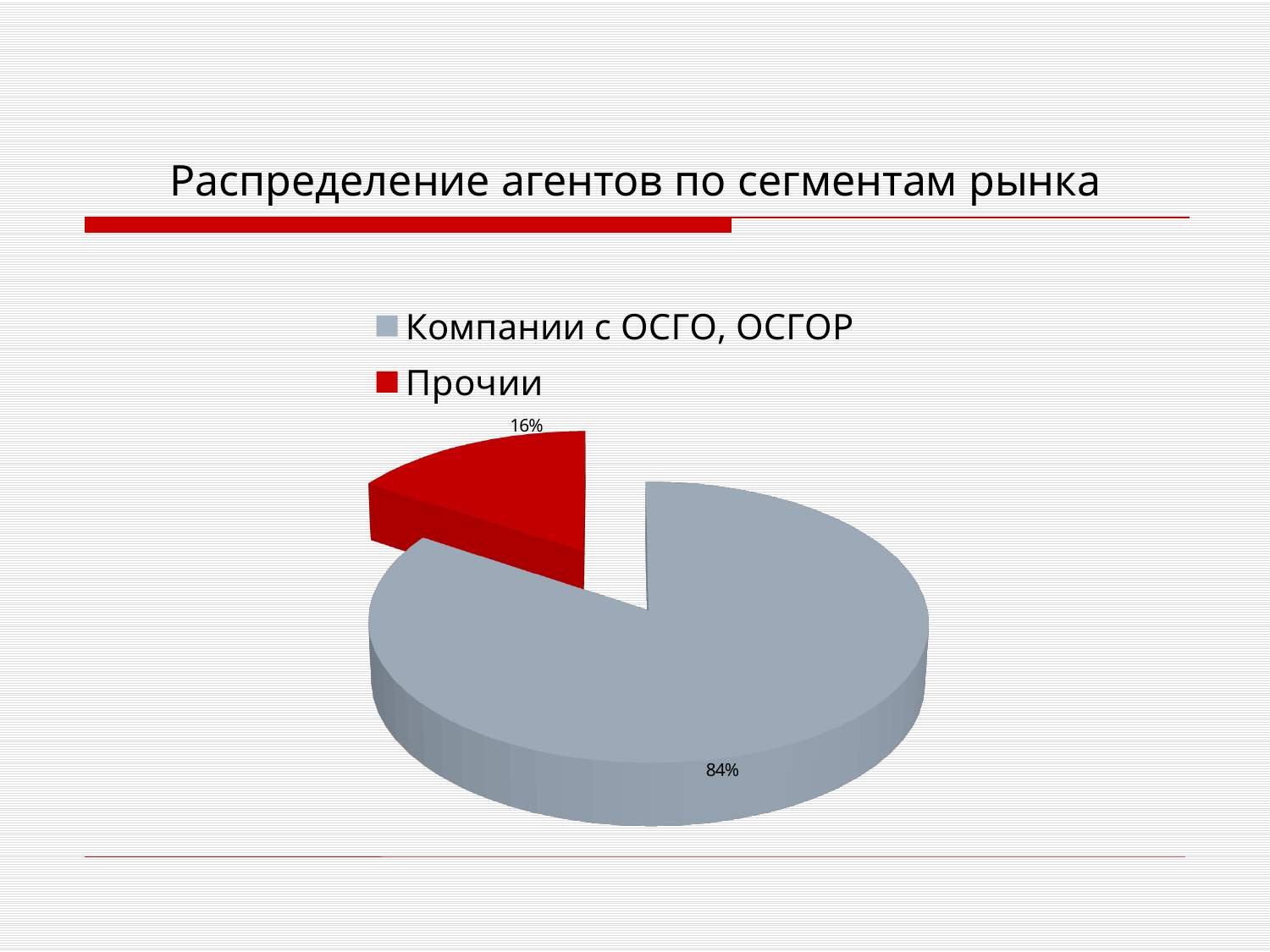
What is the difference in percentage points between the "Компании с ОСГО, ОСГОР" slice and the "Прочии" slice? 68 How many categories are shown in the pie chart? 2 What is the title of the slide? Распределение агентов по сегментам рынка What colour is the slice for "Прочии"? Red What share of the pie does "Прочии" hold? 16% How many entries does the legend list? 2 Which category has the largest slice of the pie? Компании с ОСГО, ОСГОР What kind of chart is shown on the slide? Pie chart Which is larger: the slice for "Прочии" or the slice for "Компании с ОСГО, ОСГОР"? Компании с ОСГО, ОСГОР Which category has the smallest slice of the pie? Прочии What share of the pie does "Компании с ОСГО, ОСГОР" hold? 84%